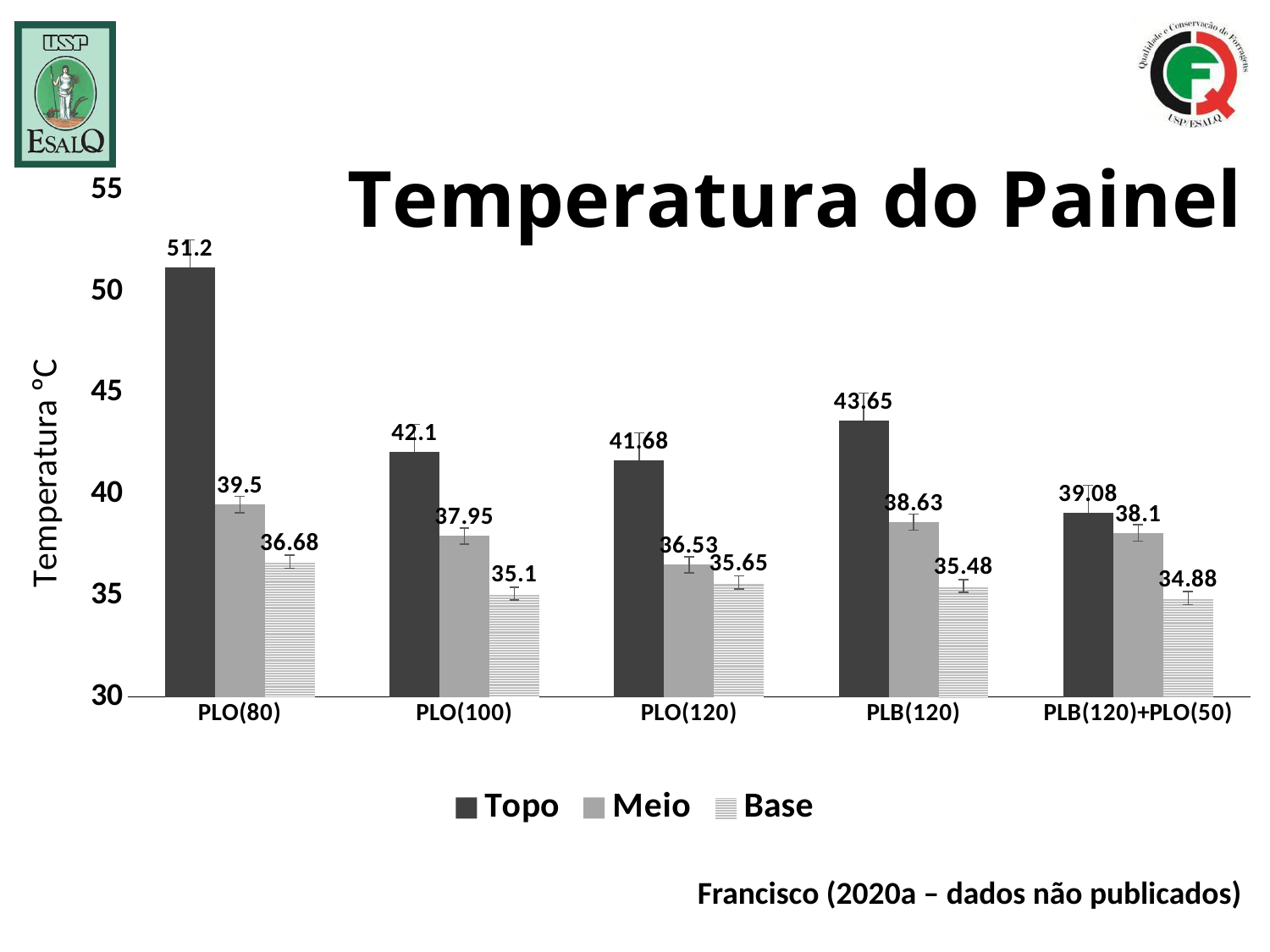
What kind of chart is shown? bar chart What is the Meio value for PLO(100)? 37.95 What is the title of the chart? Temperatura do Painel What is the Base value for PLO(120)? 35.65 What is the Topo value for PLO(80)? 51.2 What is the Base value for PLB(120)+PLO(50)? 34.88 Which category has the lowest Base value? PLB(120)+PLO(50) Which category has the highest Topo value? PLO(80) Which is larger, the Meio value for PLB(120) or the Meio value for PLO(100)? PLB(120) What is the difference between the Topo and Base values for PLO(80)? 14.52 How many series does the legend list? 3 How many categories are shown on the x axis? 5